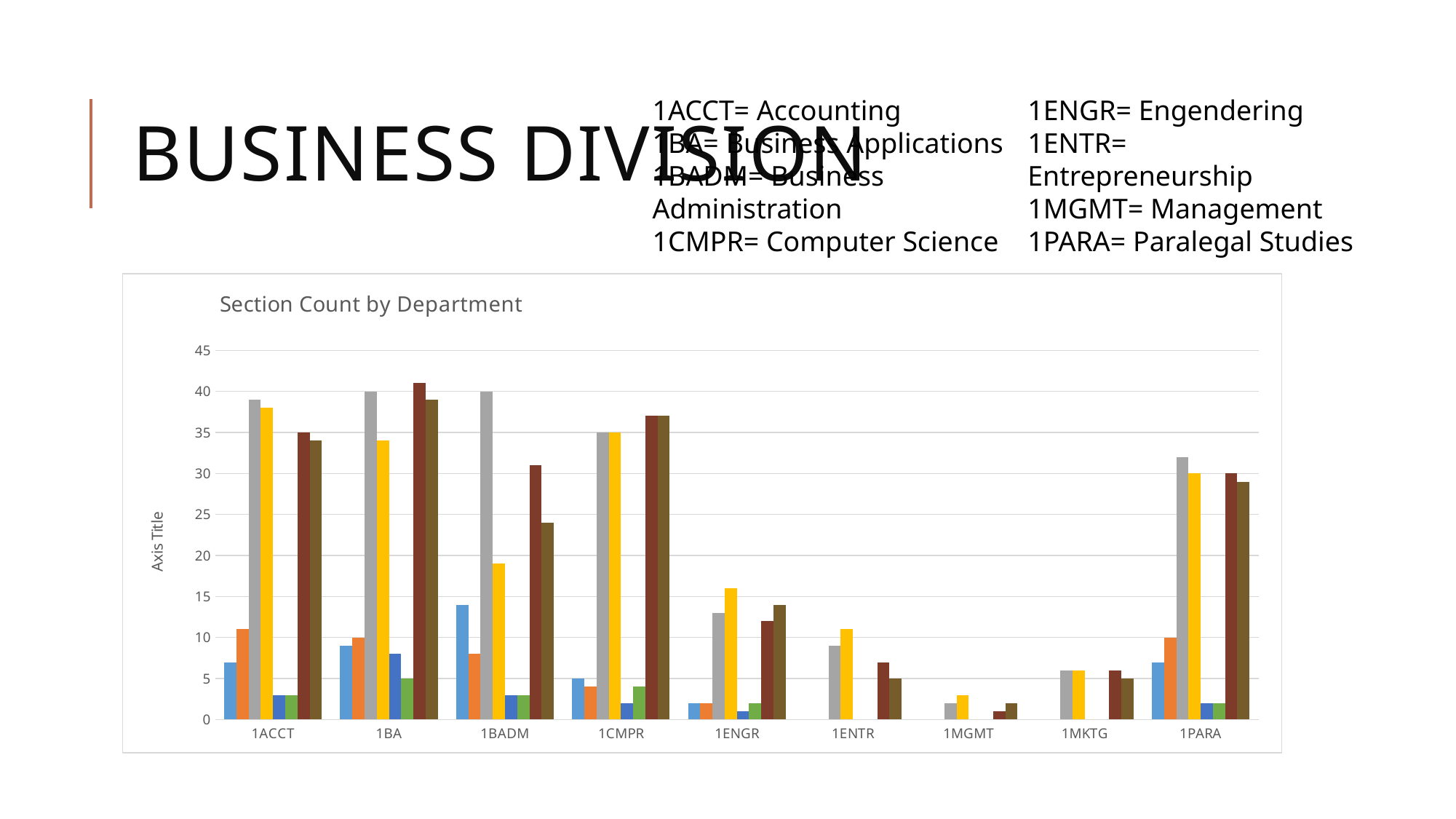
What kind of chart is shown on the slide? bar chart What is the title of the chart? Section Count by Department Is the tallest bar for 1MGMT greater or less than 5? less Which department has the lower tallest bar, 1MGMT or 1MKTG? 1MGMT Which department has the taller tallest bar, 1BA or 1ENGR? 1BA Is the tallest bar for 1ENGR greater or less than 20? less Is the tallest bar for 1PARA greater or less than 30? greater What value does the gray bar for 1BA reach? 40 How many departments are shown on the x axis of the chart? 9 What is the label on the vertical axis of the chart? Axis Title